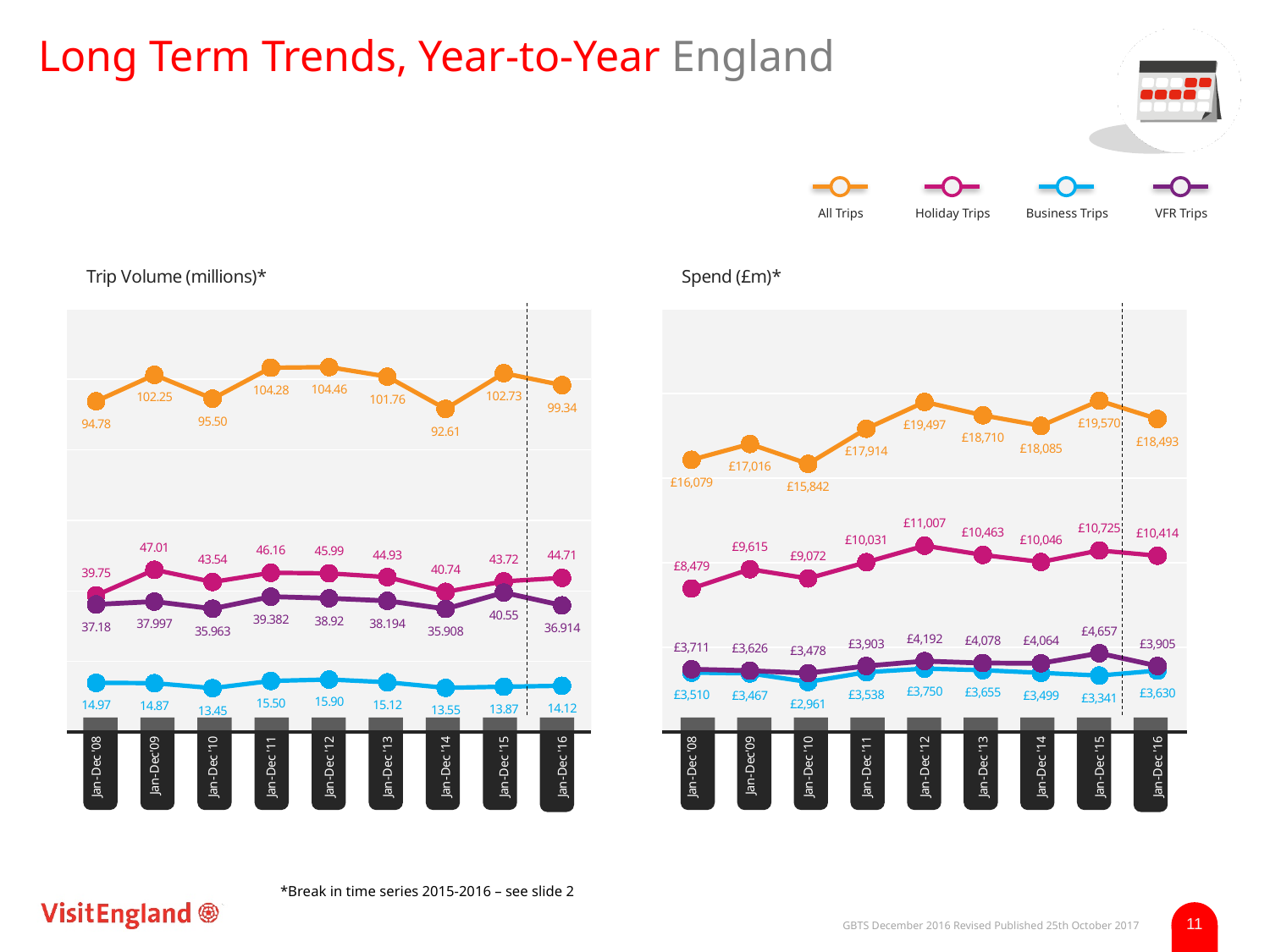
How many series does the legend list? 4 In the Spend (£m) chart, what is the value for Holiday Trips in Jan-Dec '12? £11,007 What kind of chart is the Spend (£m) chart? Line chart In the Spend (£m) chart, do Holiday Trips values rise or fall from Jan-Dec '08 to Jan-Dec '12? Rise In the Trip Volume (millions) chart, what is the value for All Trips in Jan-Dec '12? 104.46 In the Spend (£m) chart, in which period is the All Trips value lowest? Jan-Dec '10 How many periods are shown on the x axis of the Trip Volume (millions) chart? 9 In the Trip Volume (millions) chart, in which period is the All Trips value highest? Jan-Dec '12 In the Spend (£m) chart, what is the value for VFR Trips in Jan-Dec '15? £4,657 In the Spend (£m) chart, what is the difference between All Trips in Jan-Dec '15 and Jan-Dec '16? £1,077 In the Trip Volume (millions) chart, what is the difference between Business Trips in Jan-Dec '12 and Jan-Dec '10? 2.45 In the Spend (£m) chart, which is larger in Jan-Dec '16: Business Trips or VFR Trips? VFR Trips